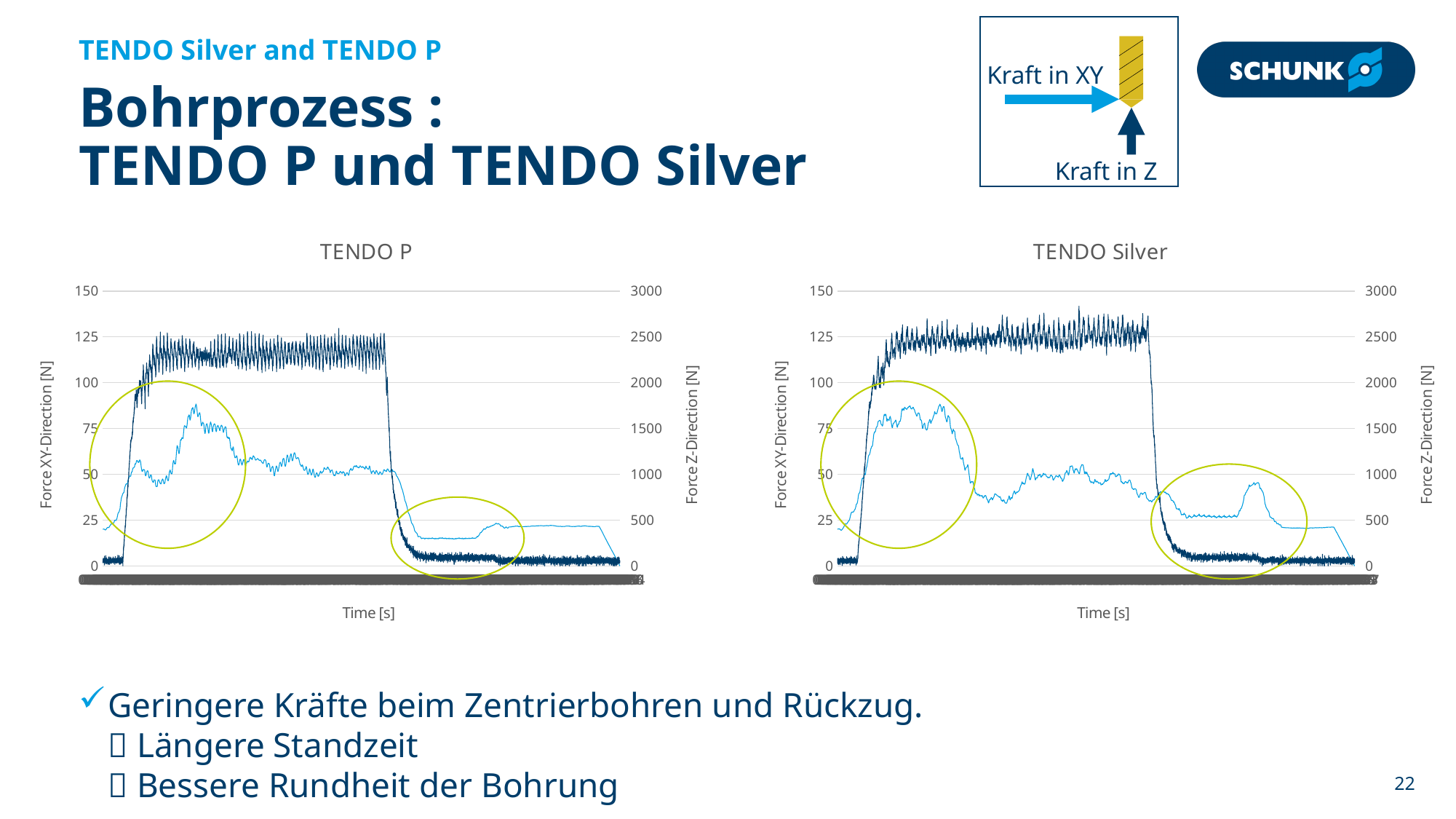
In the TENDO P chart, is the highest point of the light blue line, read against the left axis, greater or less than 100? less In the TENDO P chart, is the highest point of the light blue line, read against the left axis, greater or less than 75? greater In the TENDO Silver chart, is the plateau of the dark blue line, read against the right axis, greater or less than 2000? greater In the TENDO Silver chart, does the dark blue line rise or fall at the end of its plateau? fall What is the label of the x axis on the TENDO Silver chart? Time [s] In the TENDO P chart, does the dark blue line rise or fall at the start of the time axis? rise How many lines are plotted on the TENDO P chart? 2 In the TENDO P chart, is the peak of the light blue line higher in the first circled region or in the second circled region? first circled region What kind of chart is the TENDO P chart? line chart What is the title of the chart on the left of the slide? TENDO P